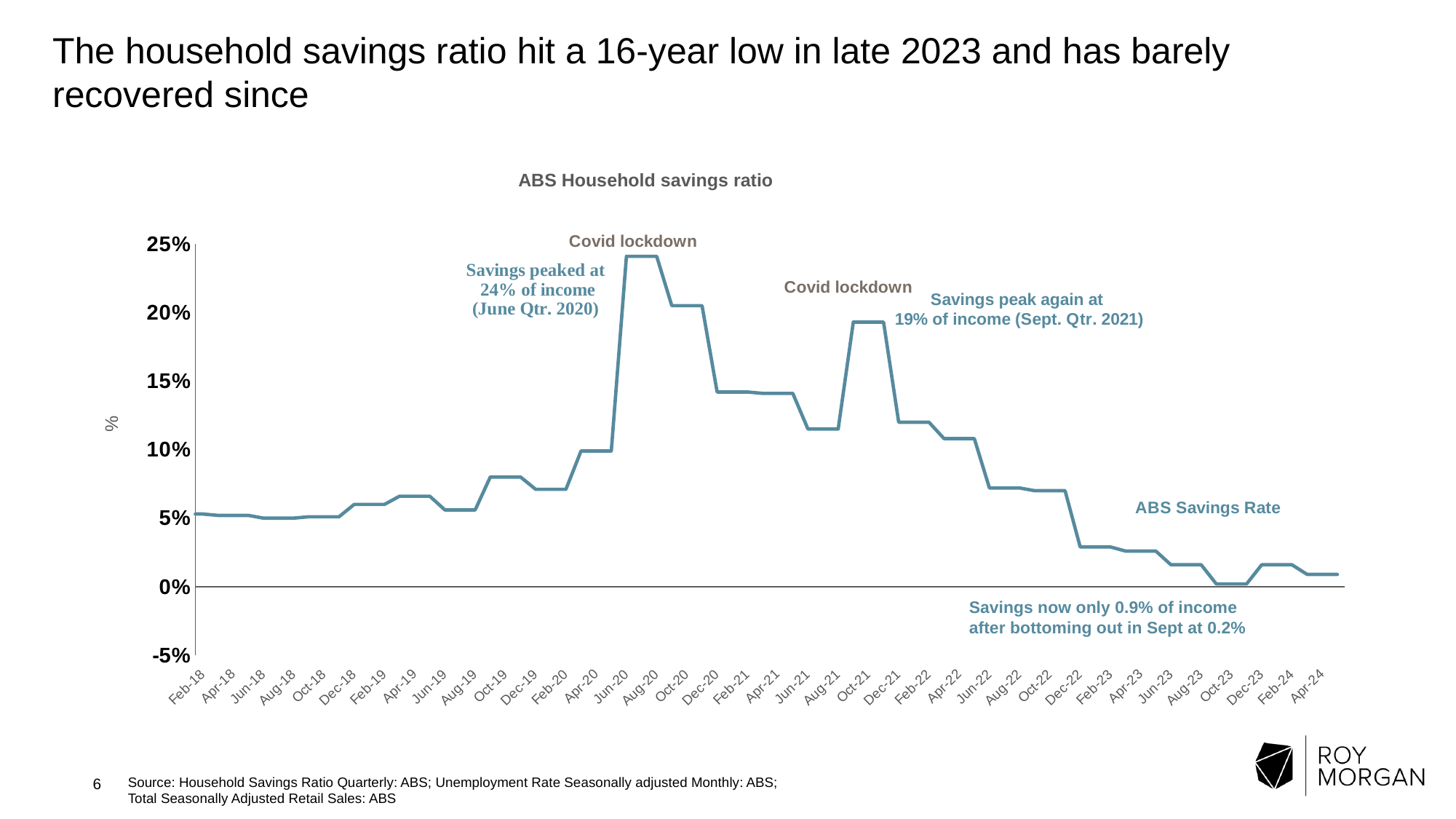
Does the savings ratio rise or fall between Oct-21 and Oct-23? fall Is the value for Dec-22 greater or less than 5%? less What kind of chart is shown on the slide? line chart According to the chart annotation, what was the household savings ratio at its second peak in the Sept. Qtr. 2021? 19% According to the chart annotation, what was the household savings ratio when it bottomed out in Sept? 0.2% According to the chart annotation, what was the peak household savings ratio in the June Qtr. 2020? 24% What is the difference in percentage points between the June Qtr. 2020 peak (24%) and the Sept. Qtr. 2021 peak (19%)? 5 percentage points Is the value for Dec-20 greater or less than 15%? less Which peak was higher: the June Qtr. 2020 peak or the Sept. Qtr. 2021 peak? June Qtr. 2020 What is the name of the series plotted on the chart? ABS Savings Rate According to the chart annotation, what is the household savings ratio now? 0.9% What is the title of the chart? ABS Household savings ratio